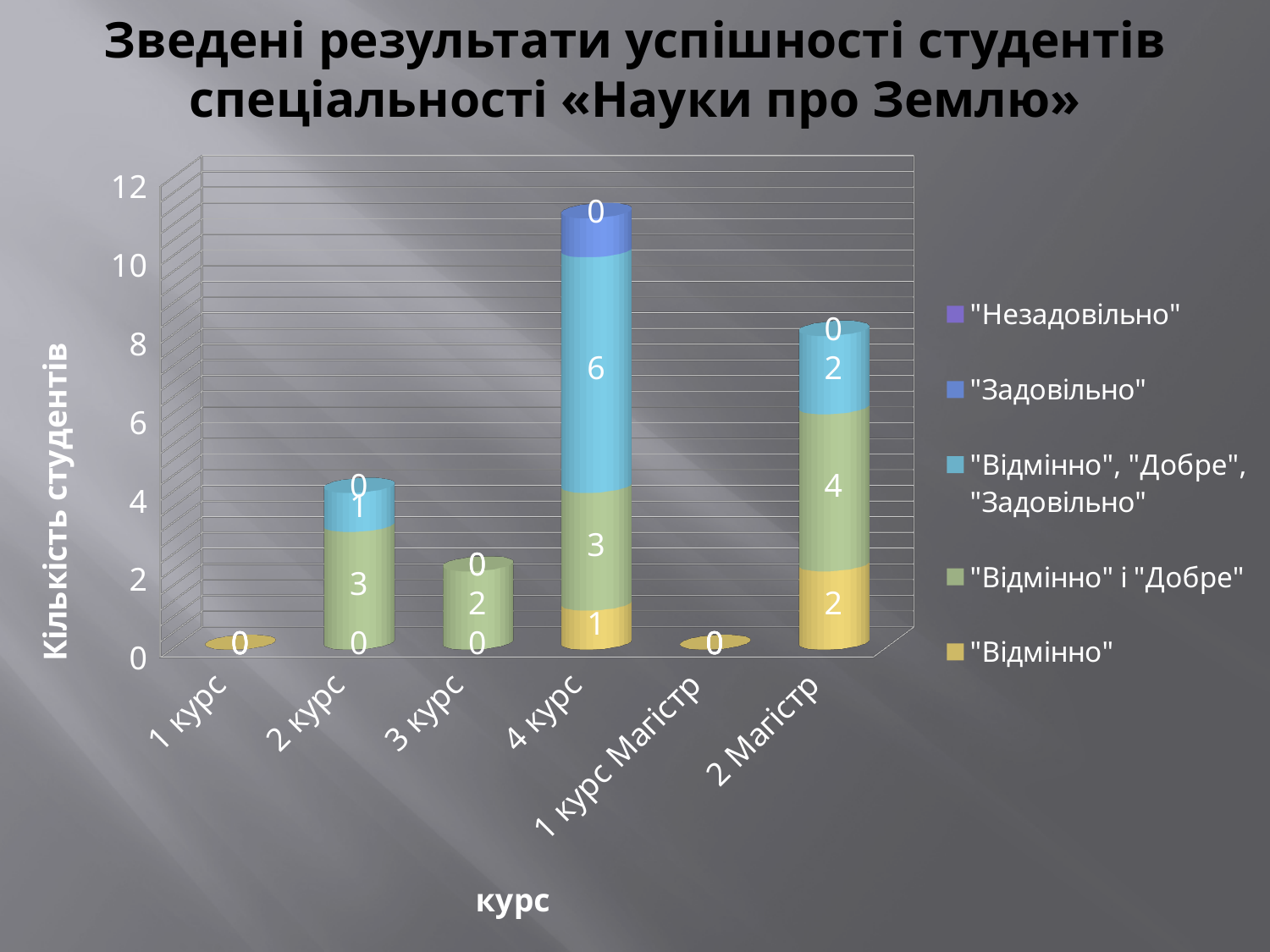
How many series does the legend list? 5 Which course has the tallest stacked bar? 4 курс Which is larger, the "Відмінно" value for 2 Магістр or for 4 курс? 2 Магістр What is the value of "Відмінно", "Добре", "Задовільно" for 4 курс? 6 What is the value of "Відмінно" for 4 курс? 1 What is the total of the stacked bar for 2 курс? 4 What is the total of the stacked bar for 2 Магістр? 8 What is the value of "Відмінно" і "Добре" for 2 курс? 3 What is the value of "Відмінно" і "Добре" for 2 Магістр? 4 How many categories (courses) are shown on the x axis? 6 What is the title of the vertical axis? Кількість студентів What kind of chart is shown on the slide? Stacked bar chart